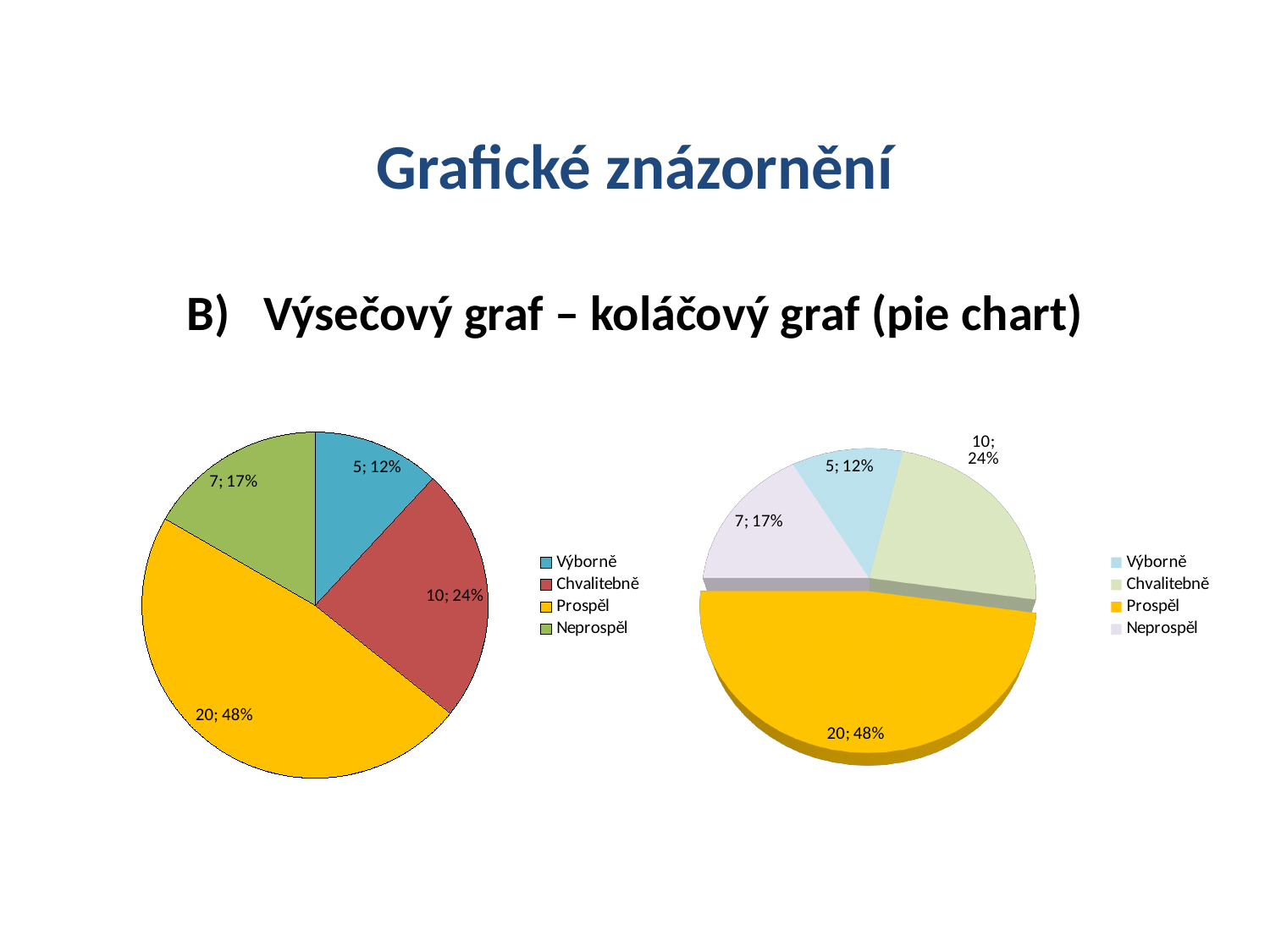
In the left pie chart, what colour is the Prospěl slice? yellow What type of chart is the chart on the right of the slide? pie chart In the right pie chart, which is larger, the value for Neprospěl or the value for Výborně? Neprospěl In the left pie chart, which category has the largest slice? Prospěl In the right pie chart, what percentage share is shown for Výborně? 12% In the right pie chart, which category has the smallest slice? Výborně In the left pie chart, what is the difference between the values for Prospěl and Chvalitebně? 10 How many slices does the left pie chart have? 4 In the left pie chart, what value is shown for Prospěl? 20 In the right pie chart, what value is shown for Neprospěl? 7 How many entries does the legend of the right chart list? 4 In the left pie chart, what percentage share is shown for Chvalitebně? 24%